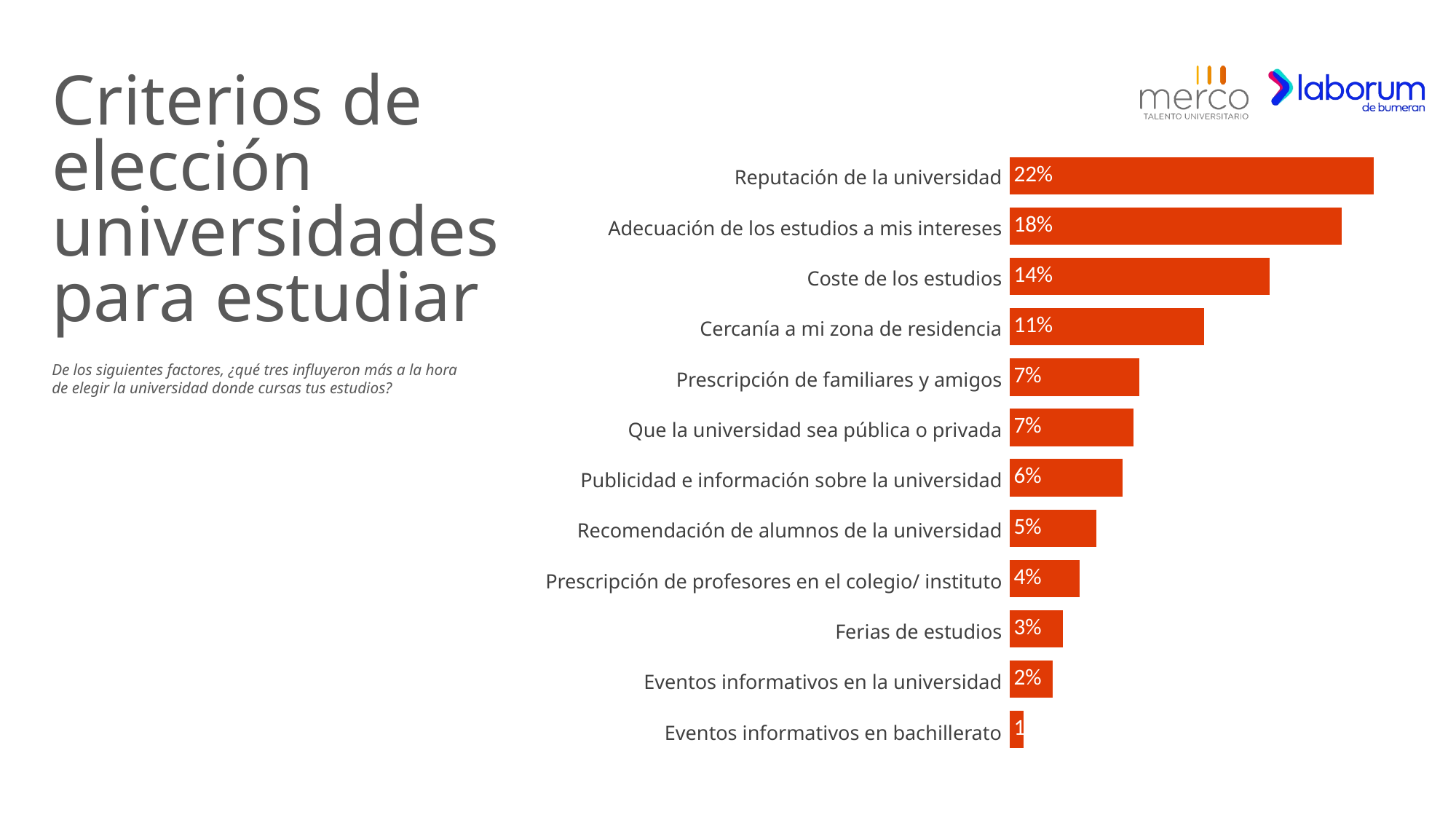
How many categories are shown in the chart? 12 Which category has the highest value? Reputación de la universidad Which category has the lowest value? Eventos informativos en bachillerato What is the value for Recomendación de alumnos de la universidad? 5% What is the difference between Reputación de la universidad and Adecuación de los estudios a mis intereses? 4% What is the value for Coste de los estudios? 14% What colour are the bars in the chart? orange-red What is the value for Ferias de estudios? 3% Which is larger, Publicidad e información sobre la universidad or Prescripción de profesores en el colegio/ instituto? Publicidad e información sobre la universidad What is the value for Reputación de la universidad? 22% What type of chart is shown on the slide? bar chart What is the value for Cercanía a mi zona de residencia? 11%